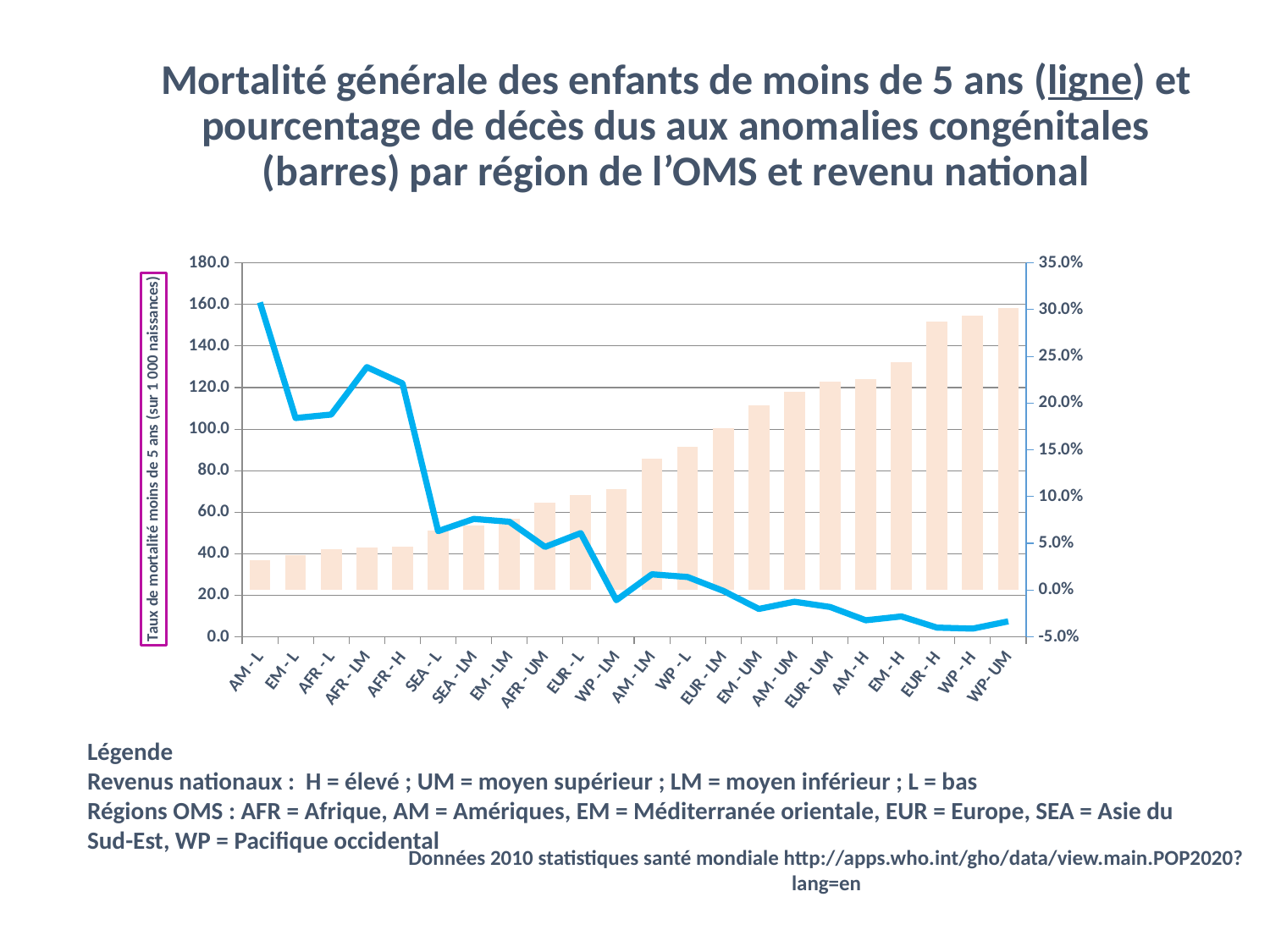
Do the bar values generally rise or fall from left to right along the x axis? rise Which category has the shortest bar? AM - L Is the bar value for AM - L greater or less than 5.0%? less What kind of chart is shown on the slide? A combined line and bar chart How many region/income categories are shown along the x axis? 22 Which has the higher line value, AFR - LM or SEA - L? AFR - LM Which category has the highest value on the line (under-5 mortality rate)? AM - L Is the line value for WP - LM greater or less than 20? less Is the bar value for WP - UM greater or less than 25.0%? greater What is the label of the left vertical axis? Taux de mortalité moins de 5 ans (sur 1 000 naissances) Which category has the tallest bar (percentage of deaths due to congenital anomalies)? WP - UM